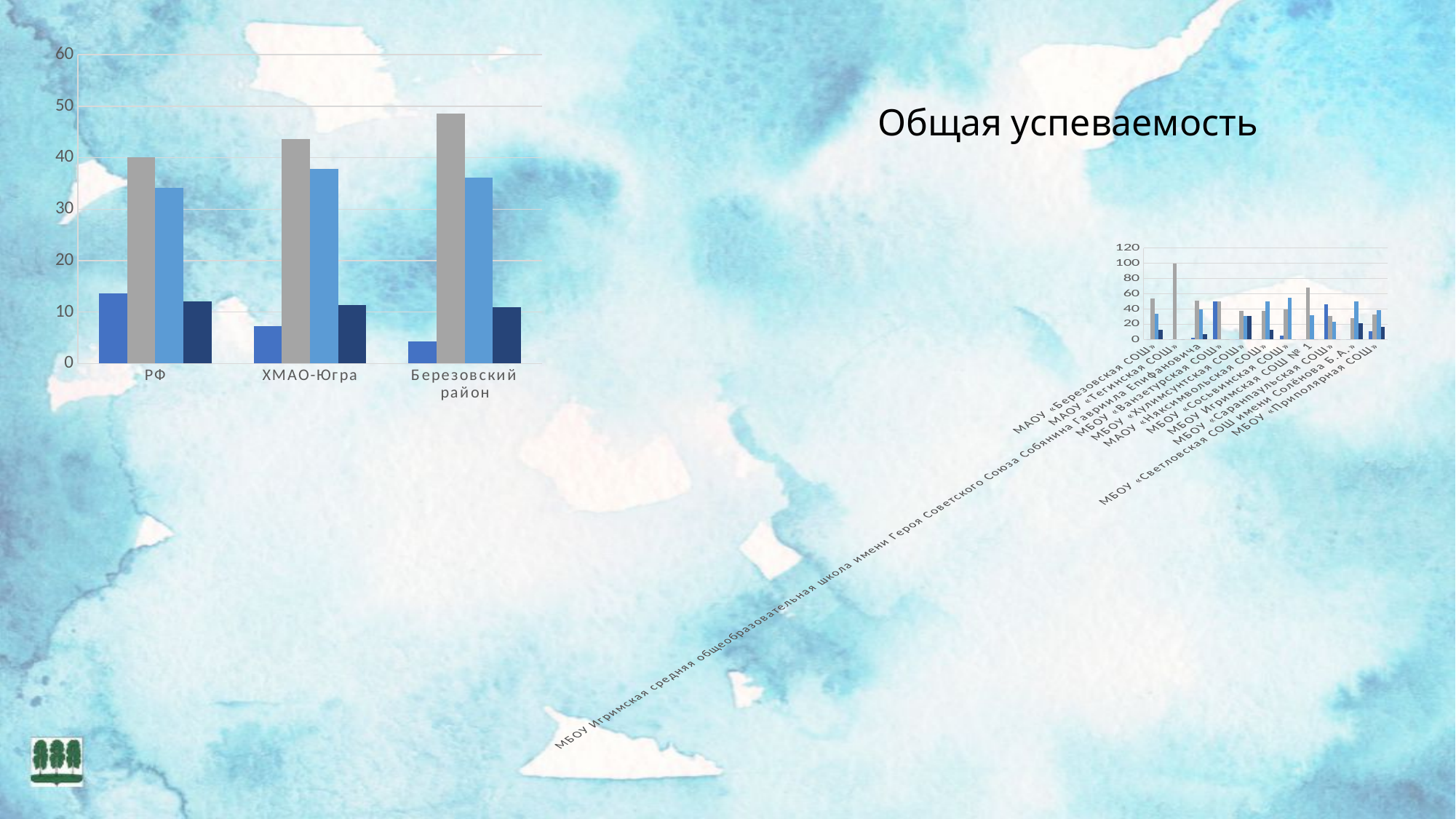
On the left chart, which category has the tallest first (dark blue) bar? РФ What is the title text shown on the slide above the right chart? Общая успеваемость On the left chart, do the grey bars rise or fall from РФ to Березовский район? rise What kind of chart is the chart on the left of the slide? bar chart On the left chart, which category has the tallest grey bar? Березовский район How many categories are shown on the x axis of the left chart? 3 What kind of chart is the small chart on the right of the slide? bar chart On the left chart, is the light blue bar for ХМАО-Югра greater or less than 30? greater On the left chart, is the first (dark blue) bar for Березовский район greater or less than 10? less On the left chart, is the grey bar for Березовский район greater or less than 40? greater On the left chart, is the grey bar for РФ larger or smaller than the grey bar for Березовский район? smaller